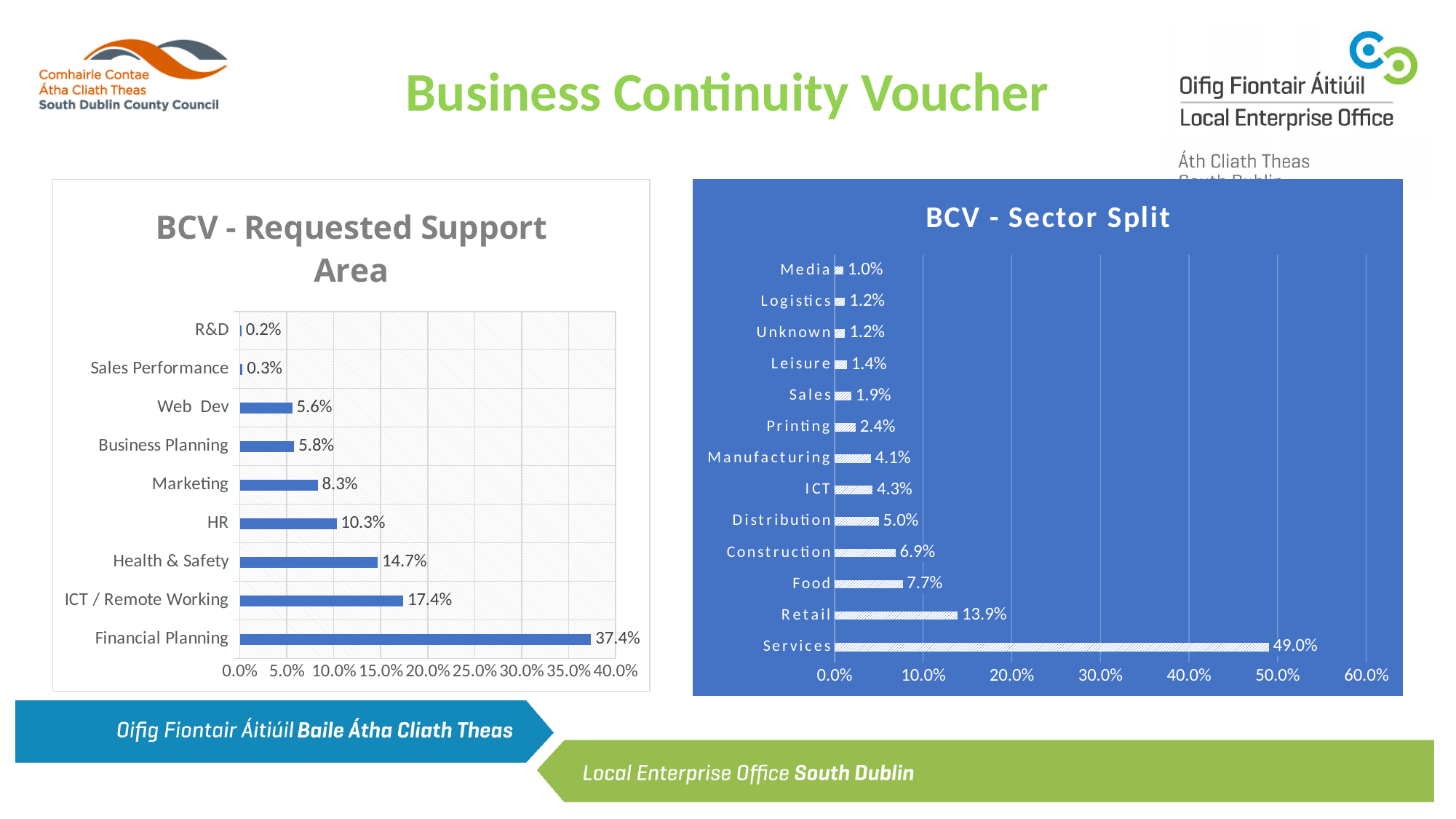
What kind of chart is the 'BCV - Sector Split' chart? Bar chart In the 'BCV - Requested Support Area' chart, what is the value for HR? 10.3% In the 'BCV - Sector Split' chart, which sector has the highest value? Services In the 'BCV - Requested Support Area' chart, what is the difference between ICT / Remote Working and Health & Safety? 2.7% In the 'BCV - Sector Split' chart, what is the value for Retail? 13.9% In the 'BCV - Requested Support Area' chart, how many categories are shown? 9 In the 'BCV - Requested Support Area' chart, what is the value for Financial Planning? 37.4% In the 'BCV - Sector Split' chart, what is the difference between Services and Retail? 35.1% In the 'BCV - Sector Split' chart, how many sectors are shown? 13 In the 'BCV - Requested Support Area' chart, which category has the lowest value? R&D In the 'BCV - Sector Split' chart, which is larger, Food or Construction? Food In the 'BCV - Sector Split' chart, what is the value for Manufacturing? 4.1%